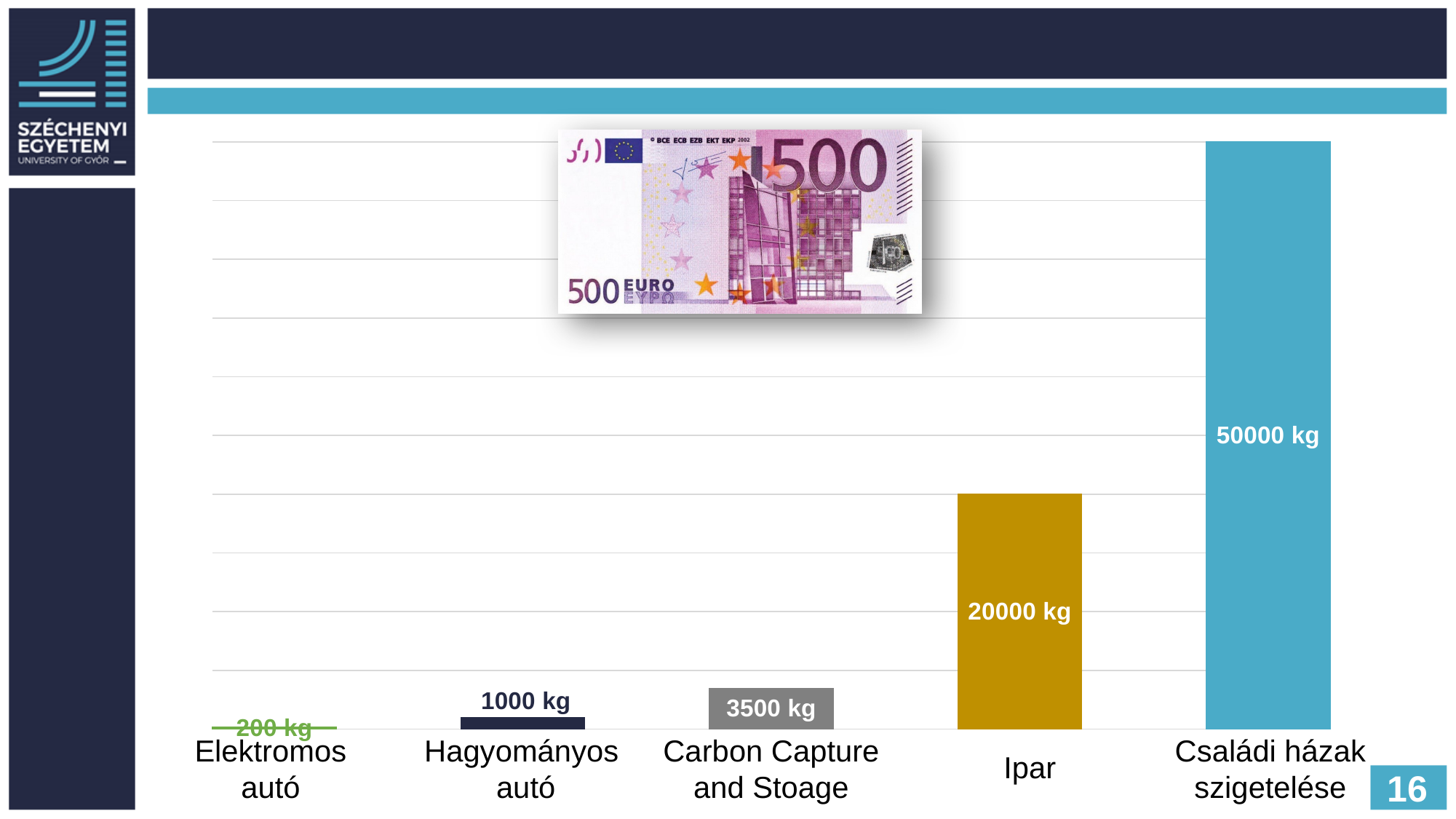
What kind of chart is shown on the slide? Bar chart What value is shown for Hagyományos autó? 1000 kg How many categories are shown in the chart? 5 What value is shown for Carbon Capture and Stoage? 3500 kg What value is shown for Elektromos autó? 200 kg What value is shown for Ipar? 20000 kg What is the difference between the values for Családi házak szigetelése and Ipar? 30000 kg Which category has the lowest value? Elektromos autó What value is shown for Családi házak szigetelése? 50000 kg What is the difference between the values for Hagyományos autó and Elektromos autó? 800 kg Which category has the highest value? Családi házak szigetelése Which is larger, the value for Carbon Capture and Stoage or the value for Hagyományos autó? Carbon Capture and Stoage